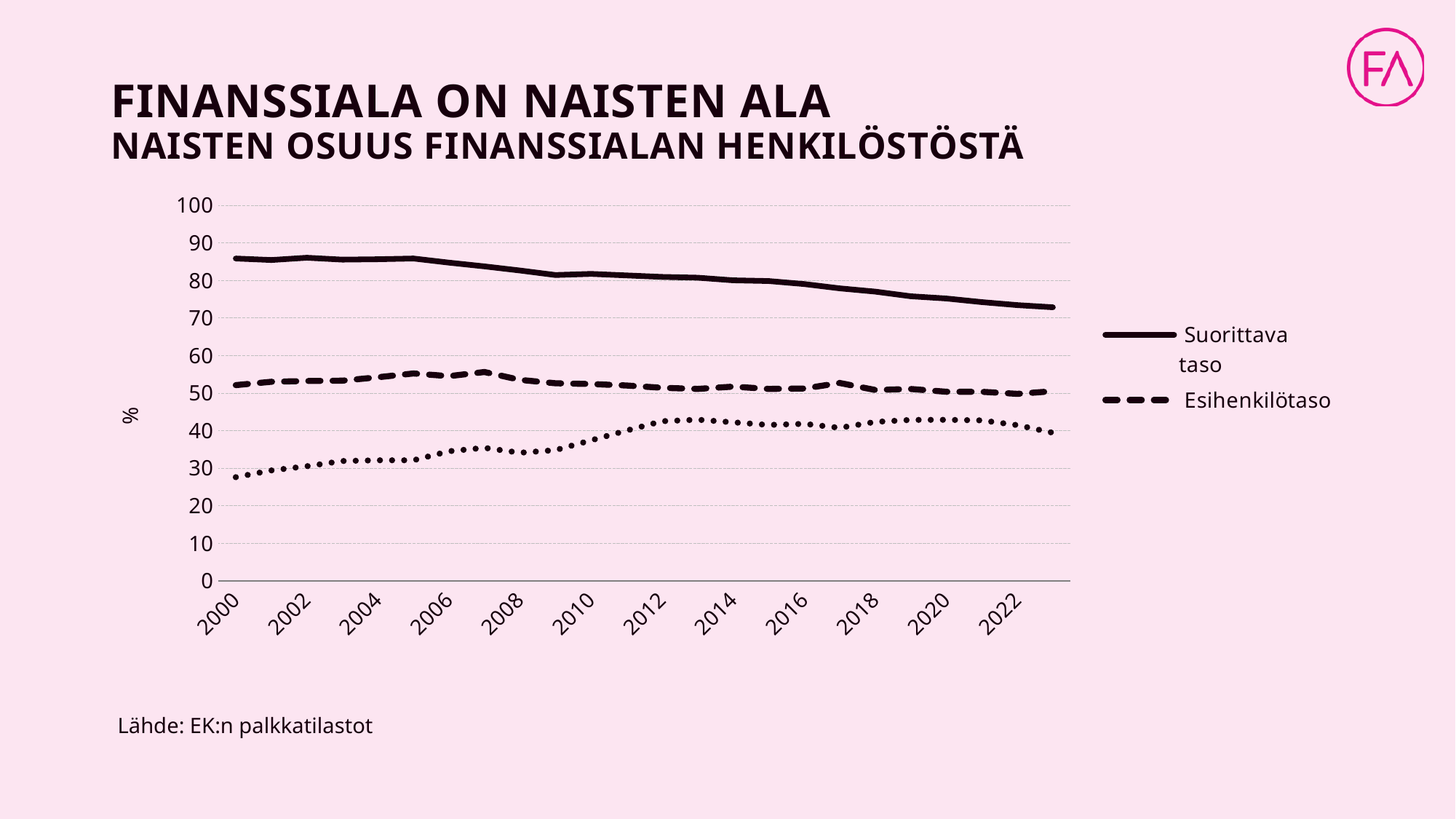
Is the value for Esihenkilötaso in 2000 greater or less than 60? less What kind of chart is shown on the slide? line chart Which series is lower in 2020, Suorittava taso or Esihenkilötaso? Esihenkilötaso Is the value for Esihenkilötaso in 2006 greater or less than 50? greater Is the value for Suorittava taso in 2022 greater or less than 80? less How many series does the legend list? 2 Which series is drawn with a dashed line in the legend? Esihenkilötaso What is the label on the vertical axis of the chart? % Which series is higher in 2010, Suorittava taso or Esihenkilötaso? Suorittava taso Does the Suorittava taso line rise or fall from 2000 to 2022? fall